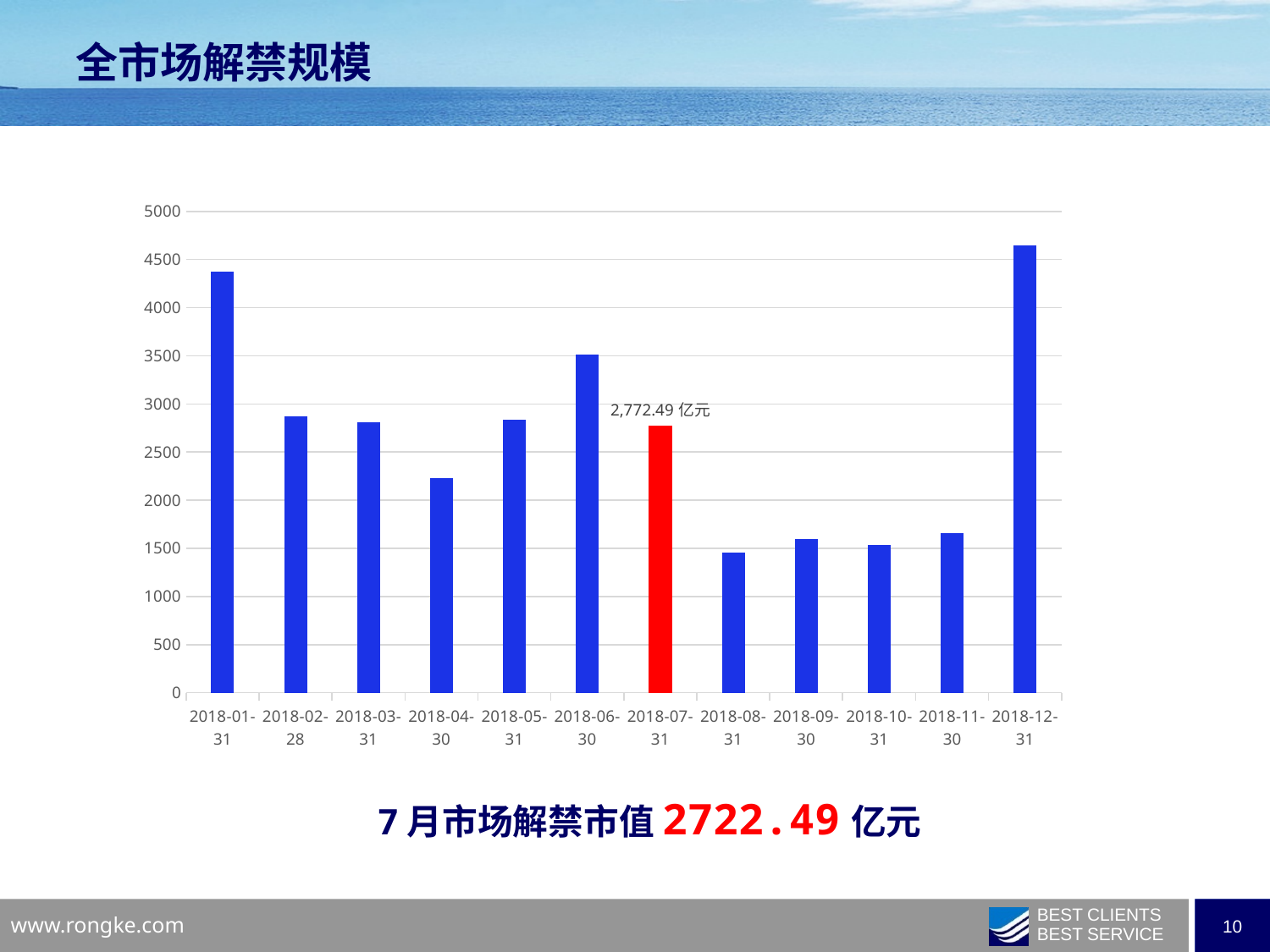
Is the value for 2018-12-31 greater or less than 4500? greater Is the value for 2018-01-31 greater or less than 4000? greater Which date's bar is coloured red? 2018-07-31 What kind of chart is shown on the slide? bar chart Is the value for 2018-06-30 greater or less than 3000? greater Which is larger, the value for 2018-01-31 or for 2018-12-31? 2018-12-31 How many bars are shown in the chart? 12 Which date has the highest bar? 2018-12-31 Which is larger, the value for 2018-06-30 or for 2018-07-31? 2018-06-30 What value is labelled on the bar for 2018-07-31? 2,772.49 亿元